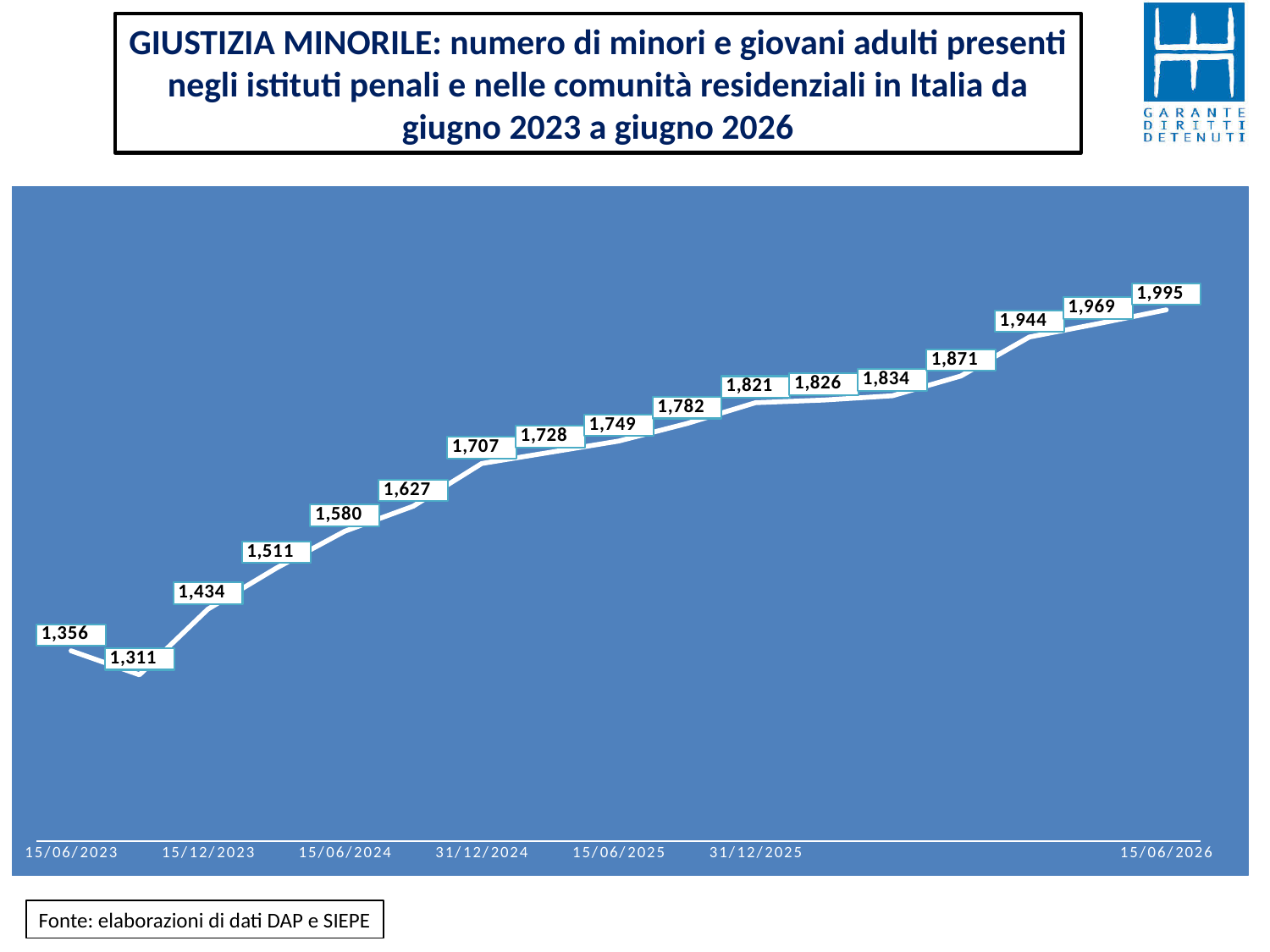
Which is larger, the value for 15/06/2023 or the value for 15/06/2026? 15/06/2026 What is the difference between the value for 15/06/2026 and the value for 15/06/2023? 639 According to the note below the chart, what is the source of the data? elaborazioni di dati DAP e SIEPE By how much does the second data point (1,311) fall below the first data point (1,356)? 45 What is the value plotted for 15/06/2023? 1,356 What is the highest value shown on the chart? 1,995 What is the value plotted for 15/06/2026? 1,995 What is the lowest value shown on the chart? 1,311 What kind of chart is shown on the slide? line chart How many data points are plotted on the line? 17 What is the date of the first point on the x axis? 15/06/2023 Overall, do the values rise or fall from 15/06/2023 to 15/06/2026? rise